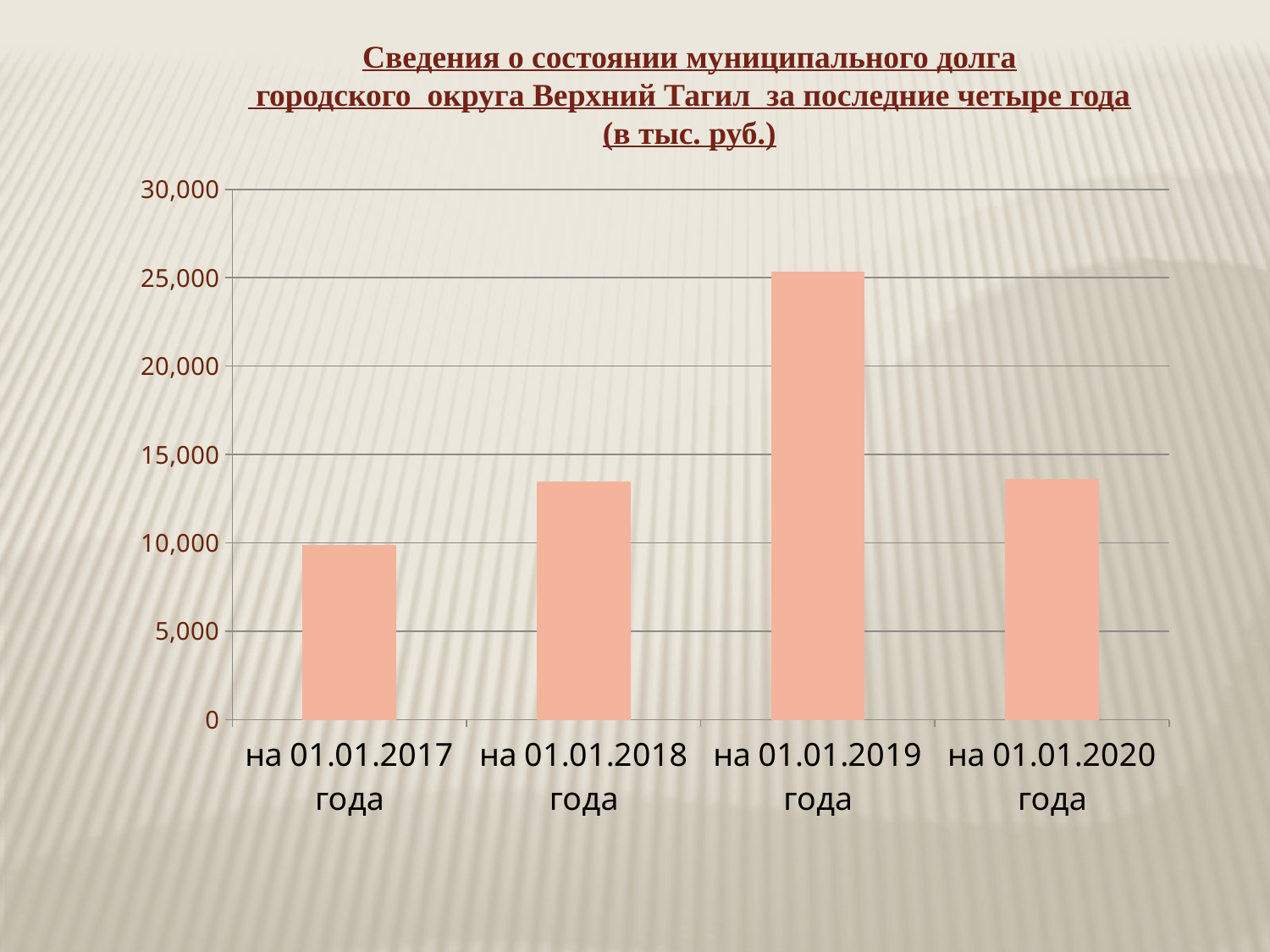
What is the maximum value shown on the vertical axis? 30,000 Is the value for на 01.01.2020 года greater or less than 10,000? greater Which is larger, the value for на 01.01.2019 года or the value for на 01.01.2020 года? на 01.01.2019 года Which date has the highest municipal debt value? на 01.01.2019 года How many bars (categories) does the chart show? 4 In what units are the values on the chart expressed, according to the title? тыс. руб. Which date has the lowest municipal debt value? на 01.01.2017 года What kind of chart is shown on the slide? bar chart Is the value for на 01.01.2019 года greater or less than 25,000? greater Which is larger, the value for на 01.01.2017 года or the value for на 01.01.2018 года? на 01.01.2018 года Is the value for на 01.01.2018 года greater or less than 15,000? less